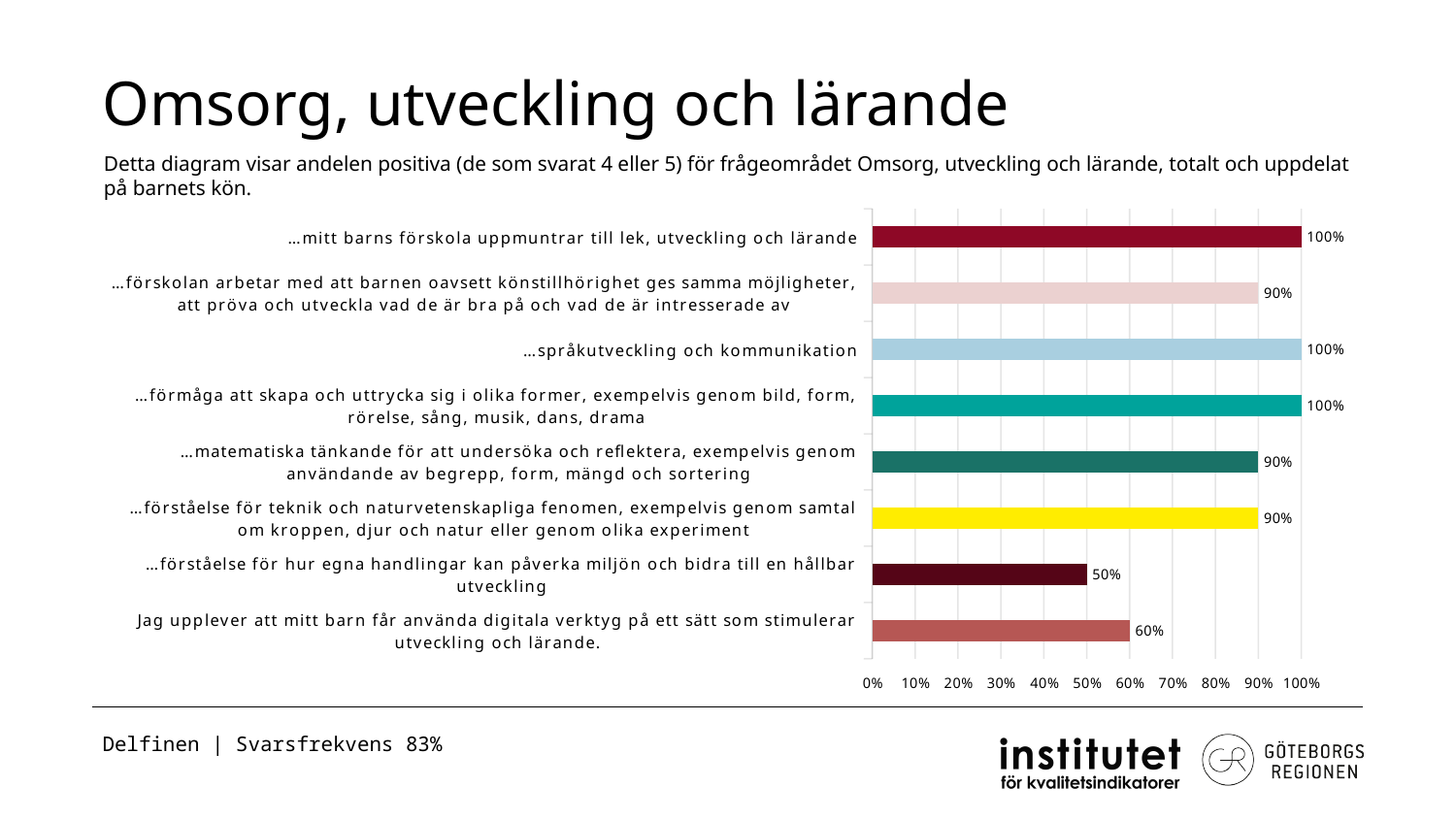
What is the value for "Jag upplever att mitt barn får använda digitala verktyg på ett sätt som stimulerar utveckling och lärande."? 60% What is the title of the slide? Omsorg, utveckling och lärande What is the value for "…matematiska tänkande för att undersöka och reflektera, exempelvis genom användande av begrepp, form, mängd och sortering"? 90% Which category has the lowest value? …förståelse för hur egna handlingar kan påverka miljön och bidra till en hållbar utveckling What is the difference between the value for "Jag upplever att mitt barn får använda digitala verktyg på ett sätt som stimulerar utveckling och lärande." and the value for "…förståelse för hur egna handlingar kan påverka miljön och bidra till en hållbar utveckling"? 10% What is the value for "…förståelse för hur egna handlingar kan påverka miljön och bidra till en hållbar utveckling"? 50% How many categories are shown in the chart? 8 What is the value for "…språkutveckling och kommunikation"? 100% How many categories have a value of 100%? 3 Which is larger: the value for "…förståelse för teknik och naturvetenskapliga fenomen, exempelvis genom samtal om kroppen, djur och natur eller genom olika experiment" or the value for "Jag upplever att mitt barn får använda digitala verktyg på ett sätt som stimulerar utveckling och lärande."? …förståelse för teknik och naturvetenskapliga fenomen, exempelvis genom samtal om kroppen, djur och natur eller genom olika experiment What is the difference between the value for "…mitt barns förskola uppmuntrar till lek, utveckling och lärande" and the value for "…förståelse för hur egna handlingar kan påverka miljön och bidra till en hållbar utveckling"? 50% What kind of chart is shown on the slide? Bar chart